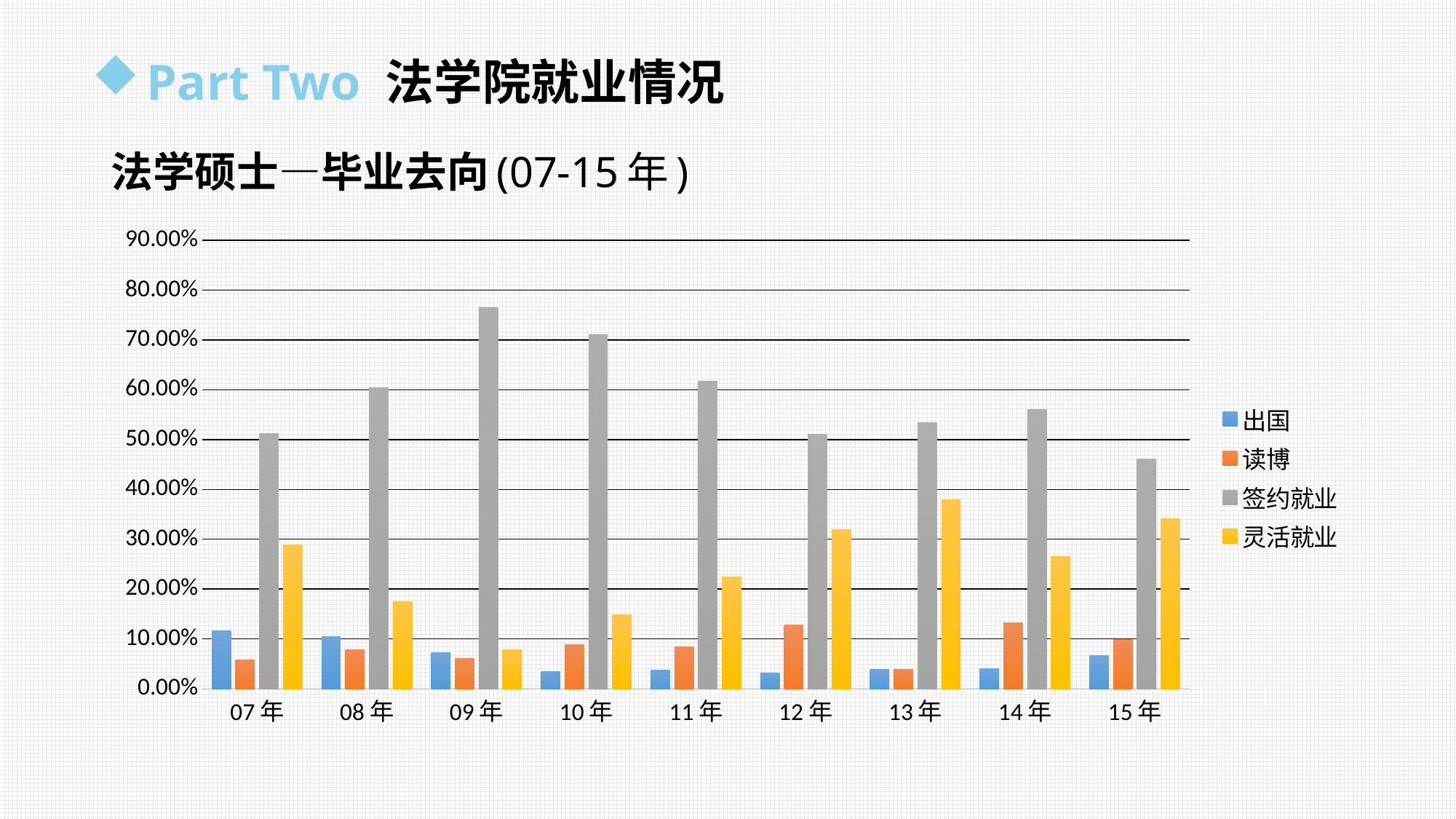
In which year is the 签约就业 value lowest? 15年 Is the 签约就业 value for 15年 greater or less than 50.00%? less What is the title of the chart? 法学硕士—毕业去向(07-15年) Is the 签约就业 value for 09年 greater or less than 70.00%? greater In which year is the 签约就业 value highest? 09年 In which year is the 灵活就业 value lowest? 09年 What kind of chart is shown on the slide? bar chart How many series does the legend list? 4 Is the 灵活就业 value for 13年 greater or less than 30.00%? greater In which year is the 灵活就业 value highest? 13年 In 07年, which is larger: 出国 or 读博? 出国 How many years are shown along the x axis? 9